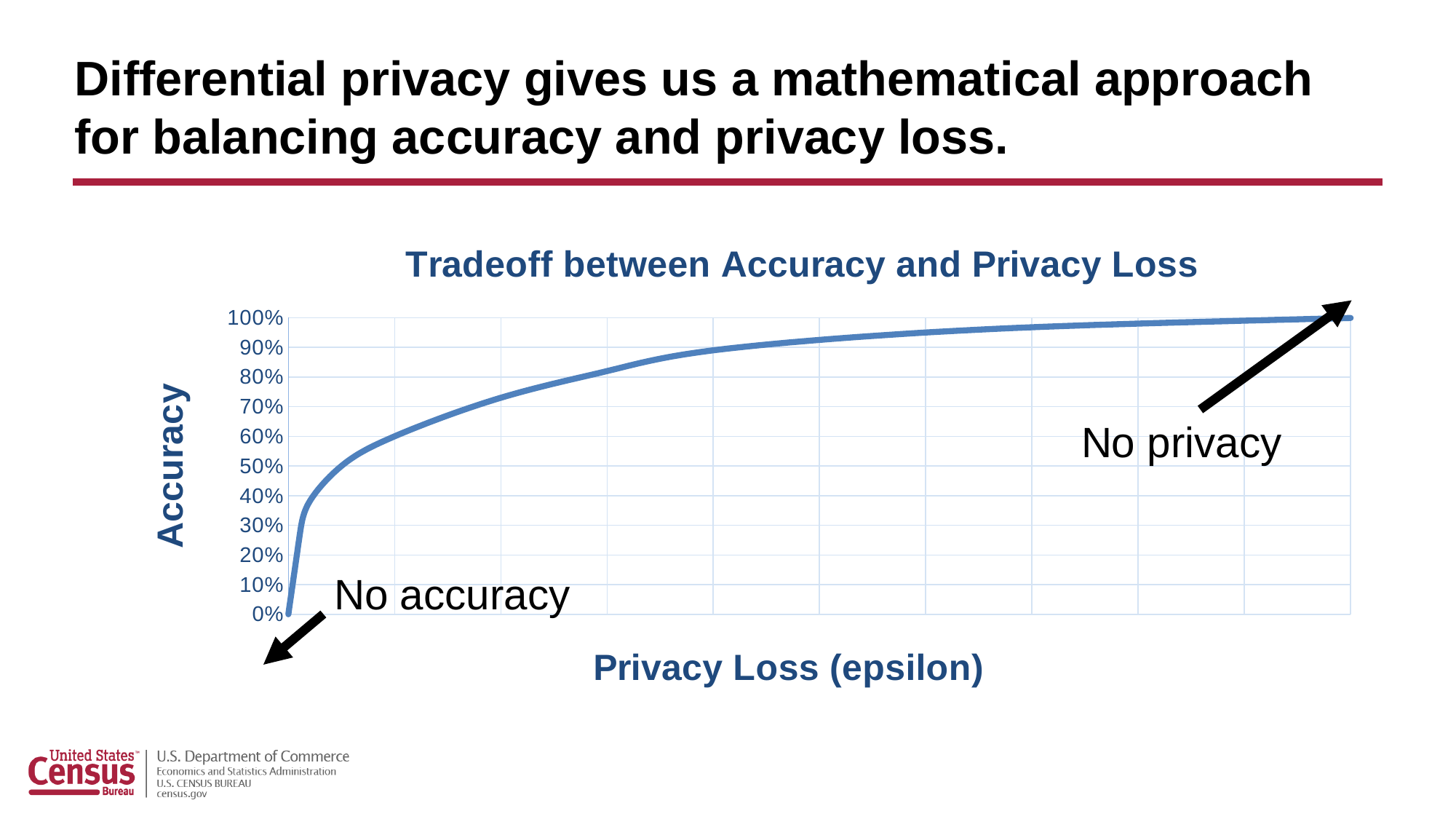
Is the accuracy at the far right end of the curve greater or less than 90%? greater What kind of chart is shown on the slide? line chart What is the title of the chart? Tradeoff between Accuracy and Privacy Loss What is the label on the x axis of the chart? Privacy Loss (epsilon) Does accuracy rise or fall as privacy loss increases along the x axis? rise Is the accuracy at the far left end of the curve greater or less than 10%? less